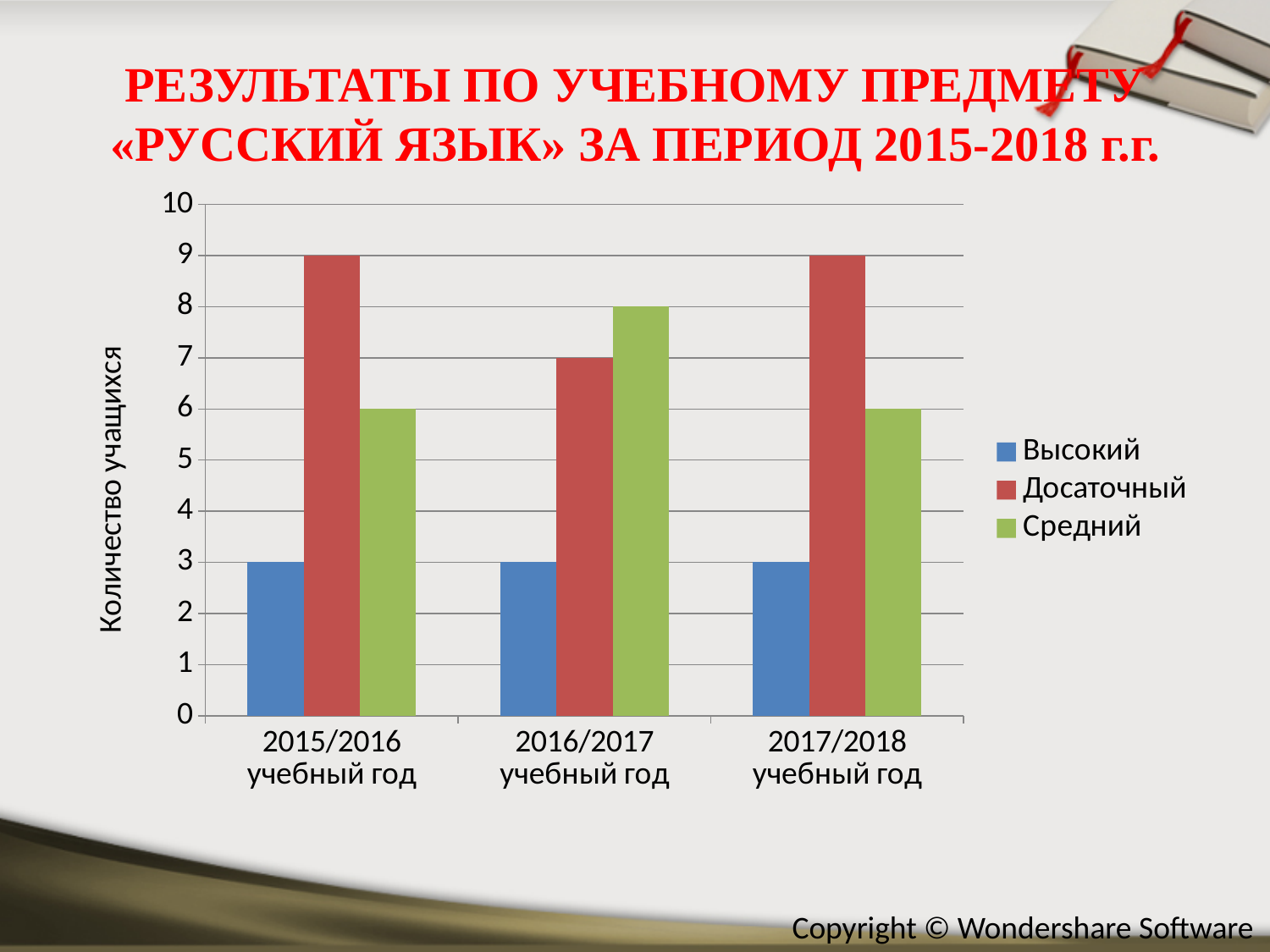
What is the value for Высокий in 2017/2018 учебный год? 3 What is the value for Досаточный in 2016/2017 учебный год? 7 In 2016/2017 учебный год, which is larger: Досаточный or Средний? Средний What is the difference between the Досаточный and Средний values in 2015/2016 учебный год? 3 What kind of chart is shown on the slide? bar chart In which academic year is the Досаточный value lowest? 2016/2017 учебный год What is the value for Средний in 2016/2017 учебный год? 8 In which academic year is the Средний value highest? 2016/2017 учебный год What is the value for Досаточный in 2015/2016 учебный год? 9 How many series does the legend list? 3 What is the label of the vertical axis? Количество учащихся How many academic-year categories are shown on the x axis? 3